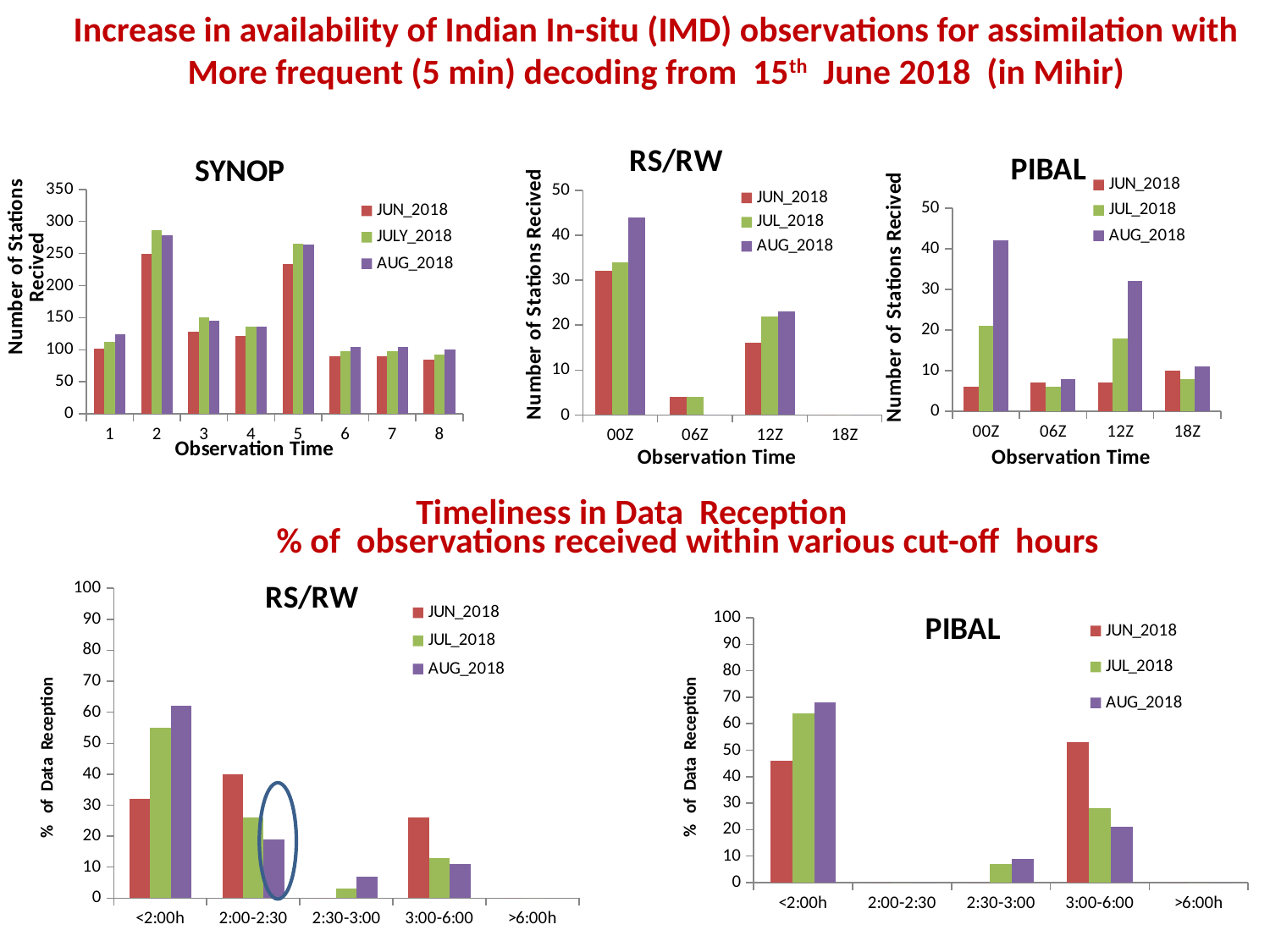
In the top RS/RW chart (Number of Stations Received), is the AUG_2018 value at 00Z greater or less than 40? greater In the top RS/RW chart (Number of Stations Received), which observation time has the highest AUG_2018 value? 00Z In the SYNOP chart, how many series does the legend list? 3 In the top PIBAL chart (Number of Stations Received), how many observation time categories are shown on the x axis? 4 In the top RS/RW chart (Number of Stations Received), is the JUN_2018 value at 12Z greater or less than 20? less In the top PIBAL chart (Number of Stations Received), is the AUG_2018 value at 00Z greater or less than 30? greater In the SYNOP chart, which observation time has the highest number of stations received? 2 In the bottom RS/RW chart (% of Data Reception), which is larger at <2:00h, JUN_2018 or AUG_2018? AUG_2018 In the bottom RS/RW chart (% of Data Reception), which cut-off category has the highest AUG_2018 value? <2:00h In the bottom RS/RW chart (% of Data Reception), how many cut-off categories are shown on the x axis? 5 What kind of chart is the bottom PIBAL chart (% of Data Reception)? bar chart